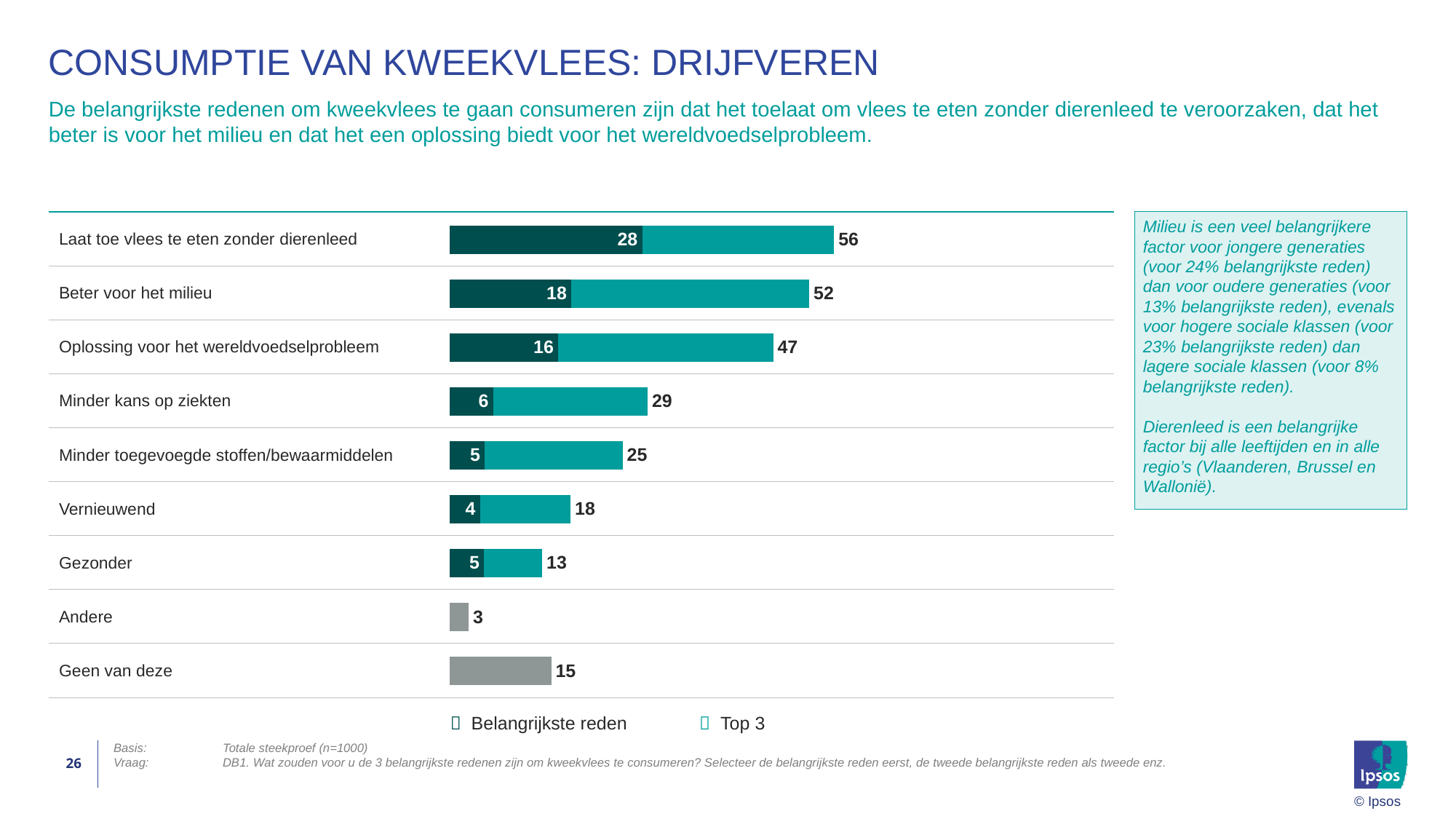
How many categories are shown in the chart? 9 What are the two series named in the legend? Belangrijkste reden and Top 3 What is the difference between the Top 3 values for 'Beter voor het milieu' and 'Minder kans op ziekten'? 23 What is the Top 3 value for 'Geen van deze'? 15 What kind of chart is shown on the slide? bar chart How many series does the legend list? 2 Which has a larger 'Belangrijkste reden' value: 'Minder kans op ziekten' or 'Vernieuwend'? Minder kans op ziekten What is the Top 3 value for 'Laat toe vlees te eten zonder dierenleed'? 56 Which category has the highest Top 3 value? Laat toe vlees te eten zonder dierenleed Which category has the lowest Top 3 value? Andere What is the Top 3 value for 'Oplossing voor het wereldvoedselprobleem'? 47 What is the 'Belangrijkste reden' value for 'Beter voor het milieu'? 18